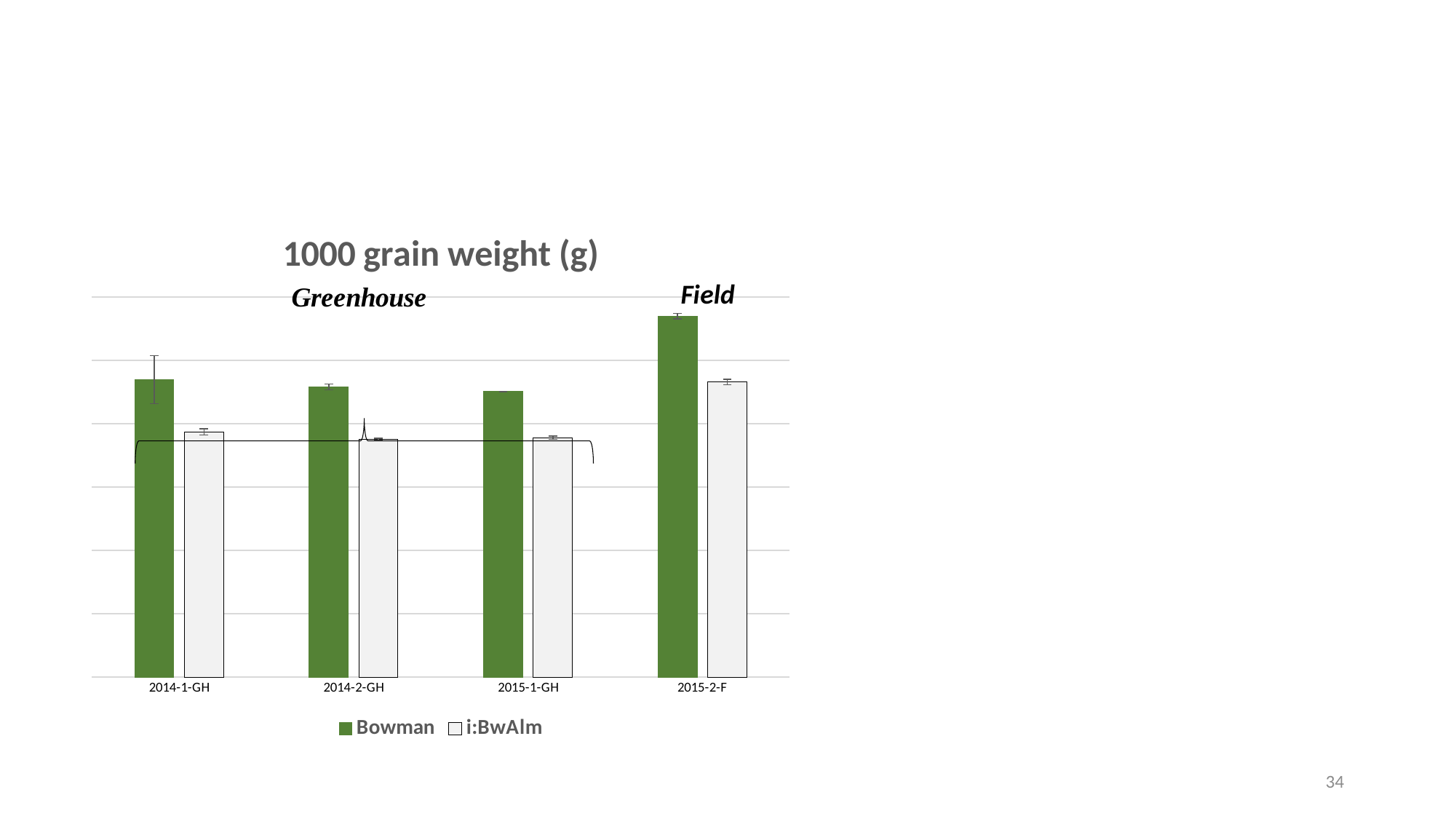
Which category has the highest Bowman value? 2015-2-F How many categories are shown on the x axis? 4 In 2015-2-F, which series has the larger value, Bowman or i:BwAlm? Bowman What kind of chart is shown on the slide? bar chart Which series is shown with green bars? Bowman Which is larger, the i:BwAlm value for 2015-1-GH or the i:BwAlm value for 2015-2-F? 2015-2-F Which is larger, the Bowman value for 2014-1-GH or the Bowman value for 2015-2-F? 2015-2-F How many series does the legend list? 2 Which category has the highest i:BwAlm value? 2015-2-F Which category is the only one labelled as Field rather than Greenhouse? 2015-2-F What is the title of the chart? 1000 grain weight (g)